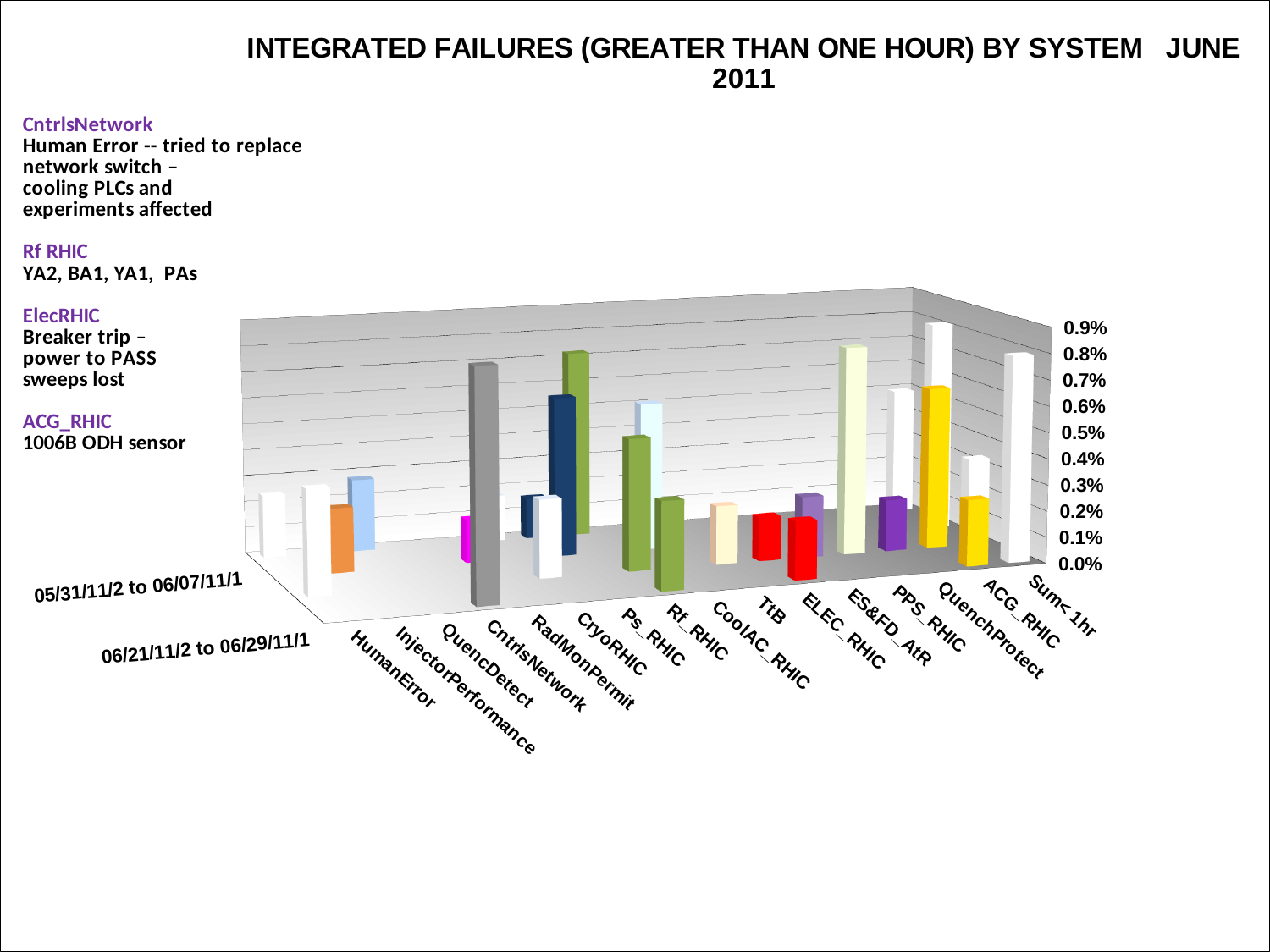
What is the title of the chart? INTEGRATED FAILURES (GREATER THAN ONE HOUR) BY SYSTEM JUNE 2011 How many system categories are plotted along the x axis of the chart? 16 Is the value for CntrlsNetwork in the 06/21/11/2 to 06/29/11/1 series greater or less than 0.3%? greater What kind of chart is shown on the slide? bar chart What is the highest tick value shown on the vertical axis of the chart? 0.9%